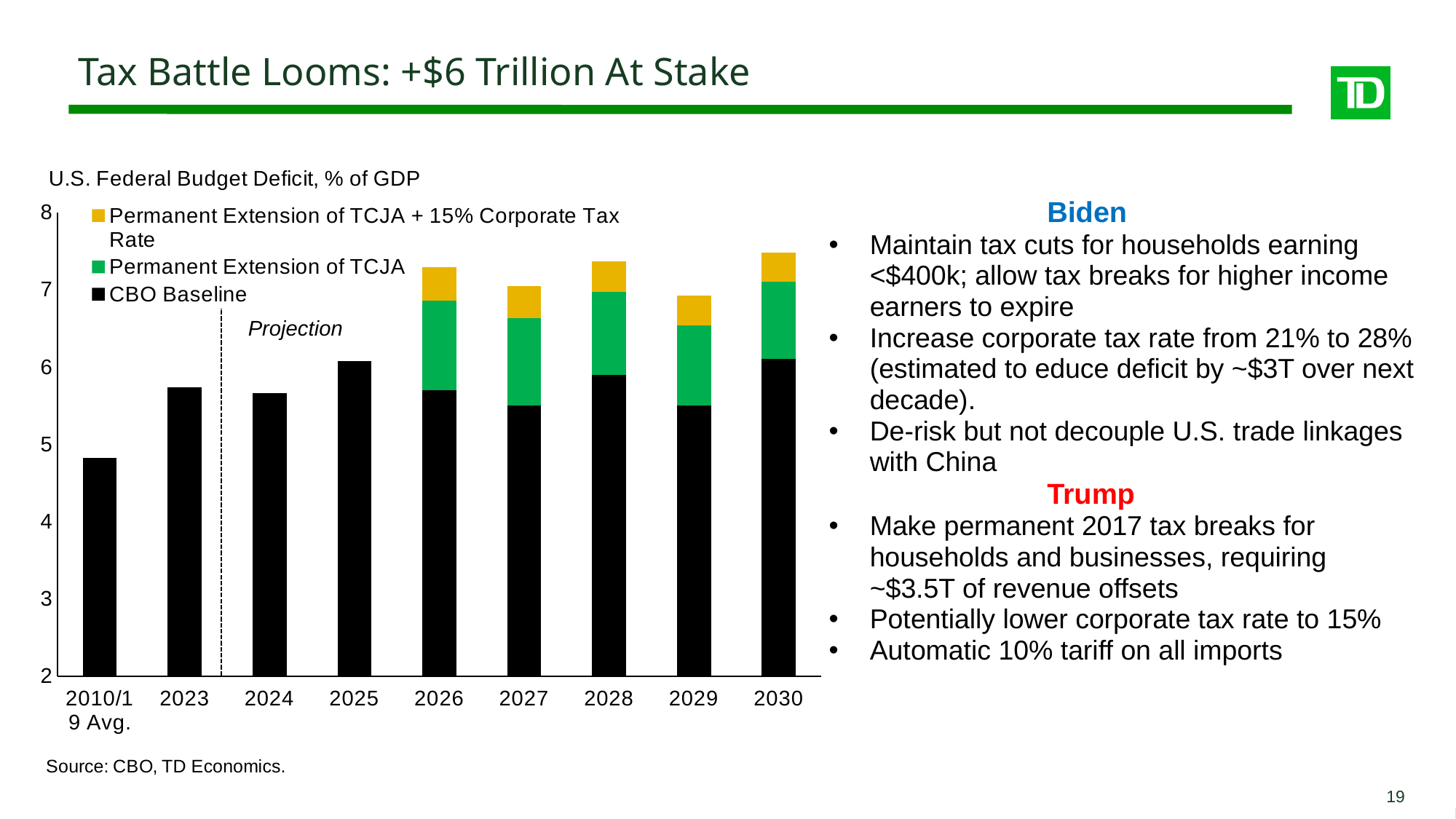
How many categories are shown along the x axis of the chart? 9 Does the CBO Baseline value rise or fall from 2010/19 Avg. to 2023? rise What kind of chart is shown on the slide? Stacked bar chart Which has the larger CBO Baseline value, 2024 or 2025? 2025 Which series in the chart is shown in black? CBO Baseline Is the CBO Baseline value for 2024 greater or less than 6? less Which category has the lowest CBO Baseline value? 2010/19 Avg. How many series does the chart legend list? 3 Is the CBO Baseline value for 2023 greater or less than 5? greater What is the title of the chart? U.S. Federal Budget Deficit, % of GDP Is the CBO Baseline value for 2010/19 Avg. greater or less than 5? less